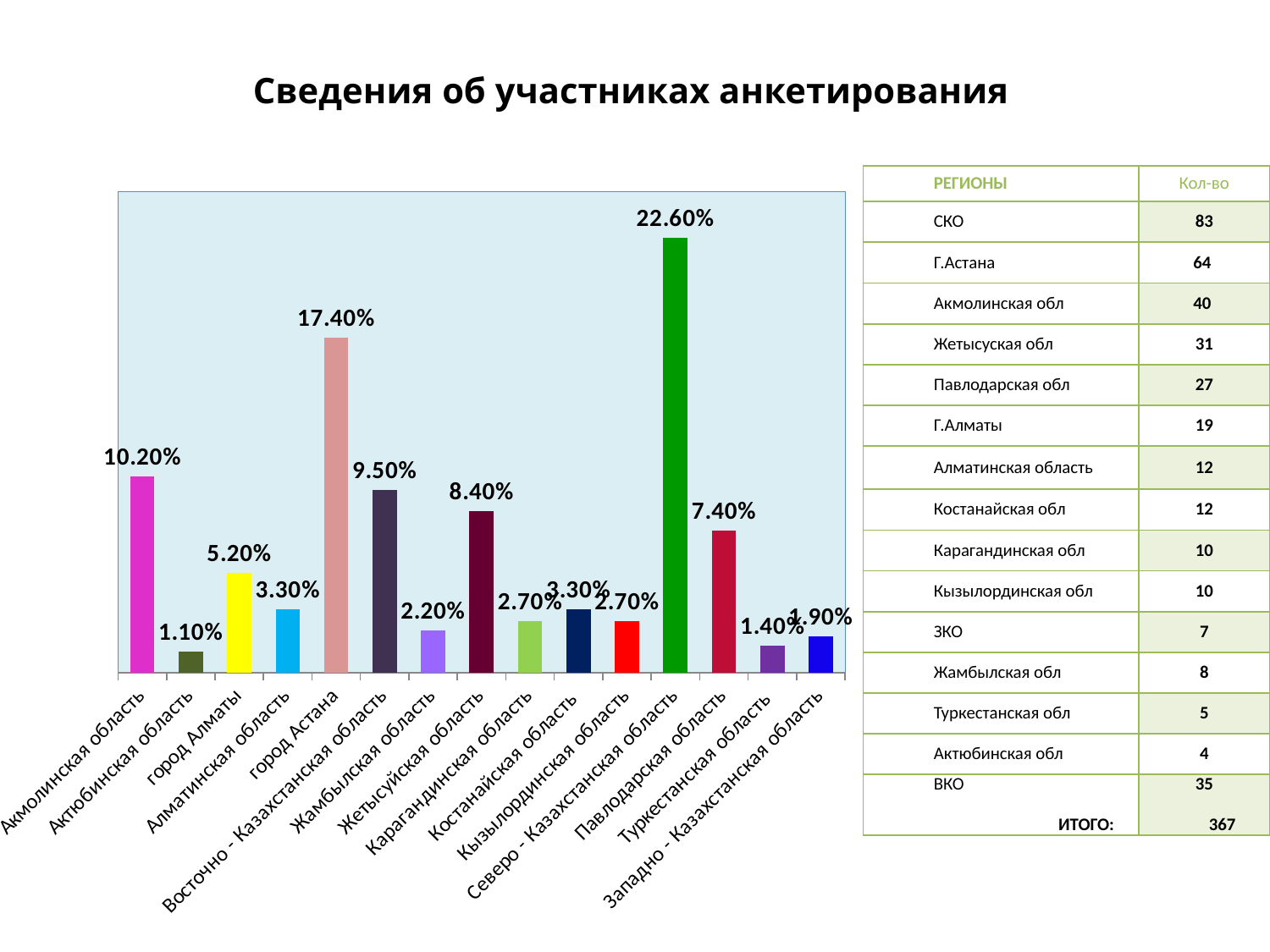
What is the value for Жетысуйская область? 8.40% What is the difference between the values for Северо - Казахстанская область and город Астана? 5.20% What is the value for Павлодарская область? 7.40% Which category has the lowest value? Актюбинская область How many categories are shown on the x axis of the chart? 15 Which category has the highest value? Северо - Казахстанская область What is the difference between the values for Акмолинская область and Восточно - Казахстанская область? 0.70% What is the value for город Астана? 17.40% What type of chart is shown on the slide? bar chart What is the value for Туркестанская область? 1.40% Which is larger, the value for город Алматы or the value for Алматинская область? город Алматы What is the title of the slide containing the chart? Сведения об участниках анкетирования